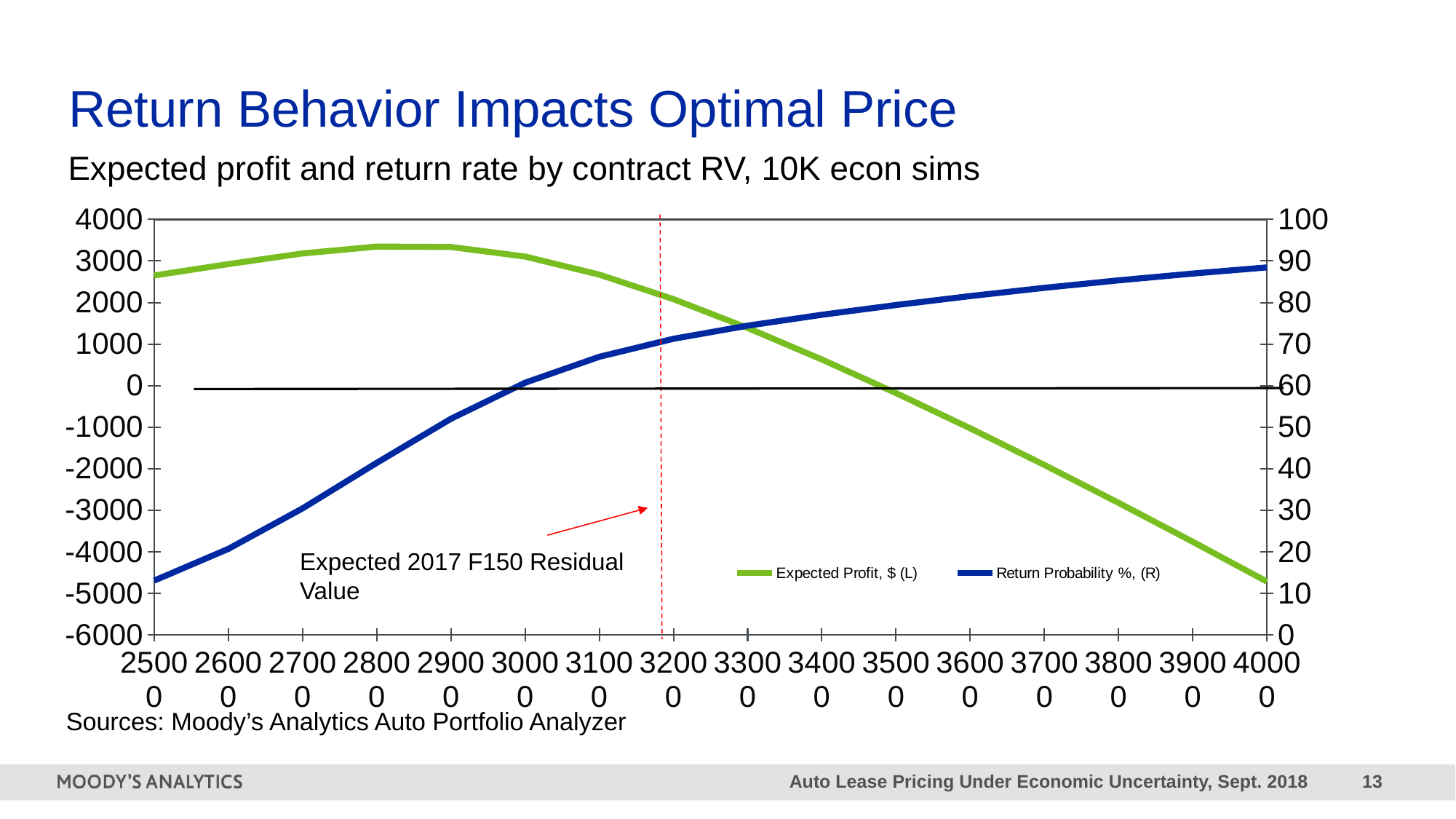
Is the Return Probability value at 35000 greater or less than 70? greater Is the Expected Profit value at 40000 greater or less than -4000? less Is the Return Probability value at 25000 greater or less than 20? less What kind of chart is shown on the slide? line chart What are the two series named in the legend? Expected Profit, $ (L) and Return Probability %, (R) How many series does the legend list? 2 Which colour is used for the Return Probability %, (R) line? blue How many labelled tick marks are on the x axis? 16 Does the Return Probability line rise or fall as the contract RV increases along the x axis? rises Does the Expected Profit line rise or fall between 30000 and 40000 on the x axis? falls